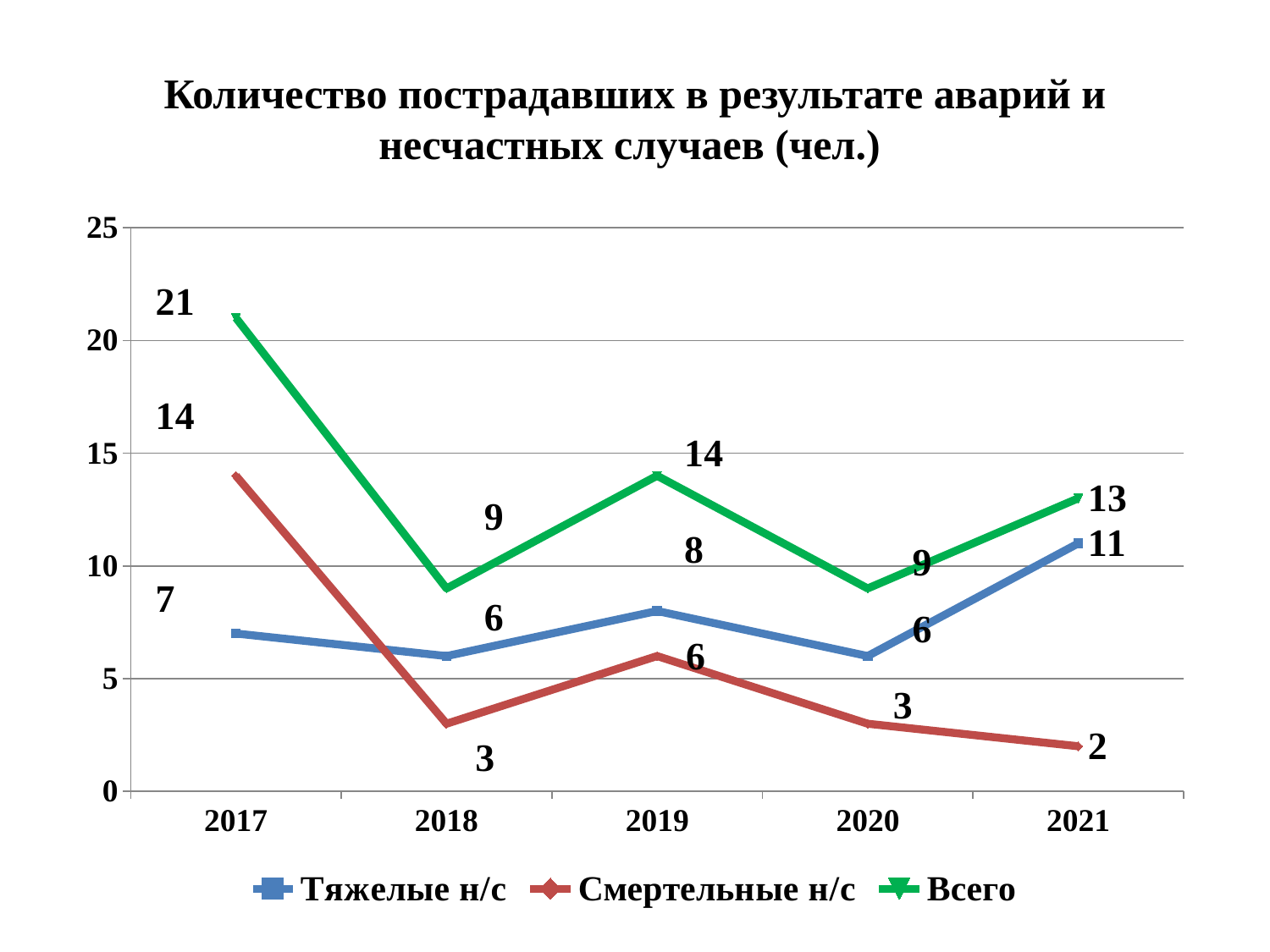
How many years are shown on the x axis? 5 What is the value of Тяжелые н/с in 2019? 8 What is the value of Всего in 2017? 21 What is the value of Смертельные н/с in 2021? 2 Does Смертельные н/с rise or fall from 2019 to 2021? Fall Which is larger in 2017: Тяжелые н/с or Смертельные н/с? Смертельные н/с What is the difference between Всего in 2017 and Всего in 2018? 12 What kind of chart is shown on the slide? Line chart In which year is Всего highest? 2017 How many series does the legend list? 3 In which year is Смертельные н/с lowest? 2021 What colour is the line for Всего? Green